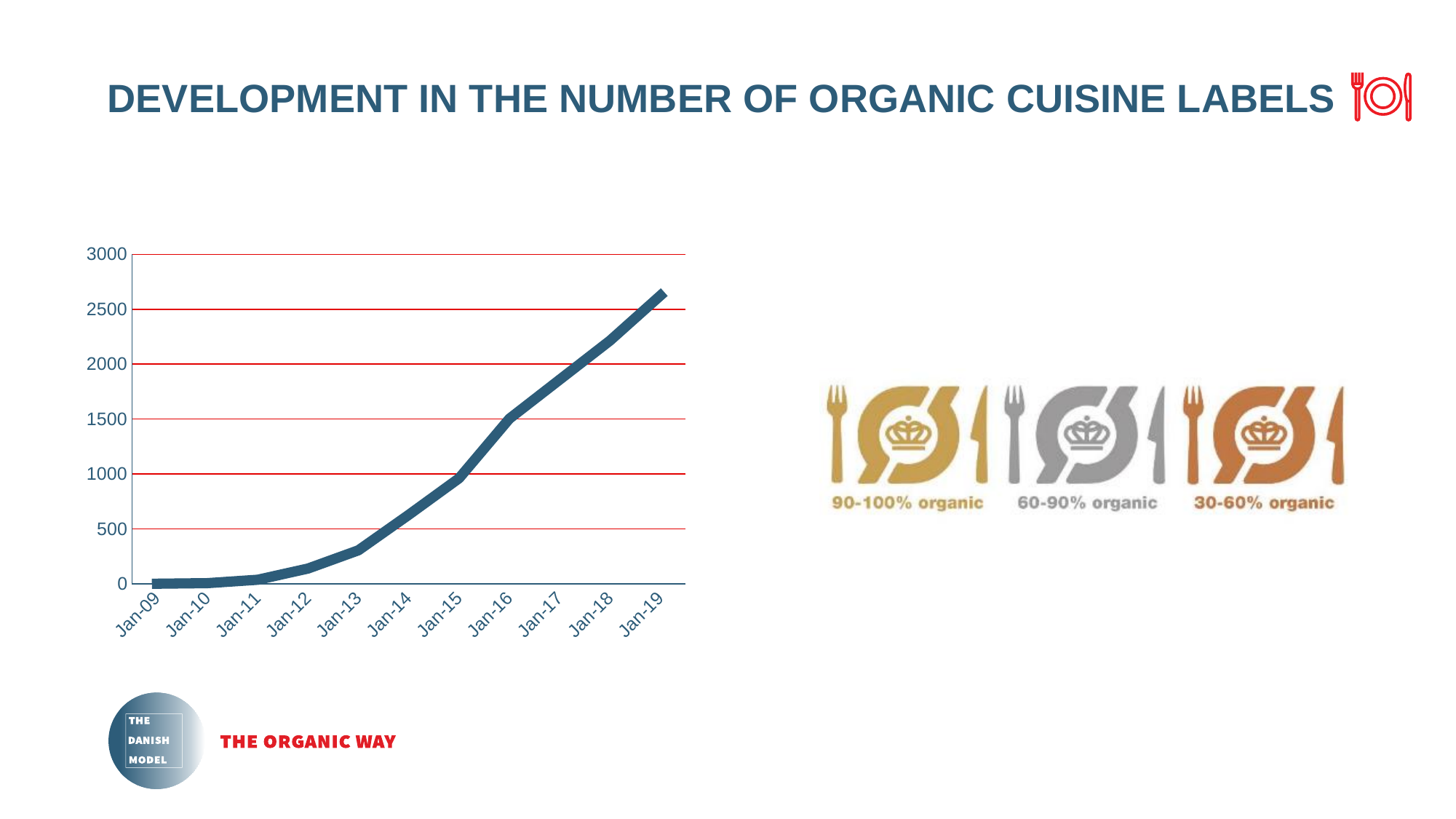
What kind of chart is shown on the slide? line chart Is the value for Jan-13 greater or less than 500? less What is the title of the slide containing the chart? DEVELOPMENT IN THE NUMBER OF ORGANIC CUISINE LABELS Which is larger, the value for Jan-18 or the value for Jan-14? Jan-18 Is the value for Jan-18 greater or less than 2000? greater How many data points are plotted along the x axis of the chart? 11 Is the value for Jan-19 greater or less than 2500? greater What is the highest value shown on the y axis of the chart? 3000 Do the values rise or fall from Jan-09 to Jan-19? rise Which date on the x axis has the highest value? Jan-19